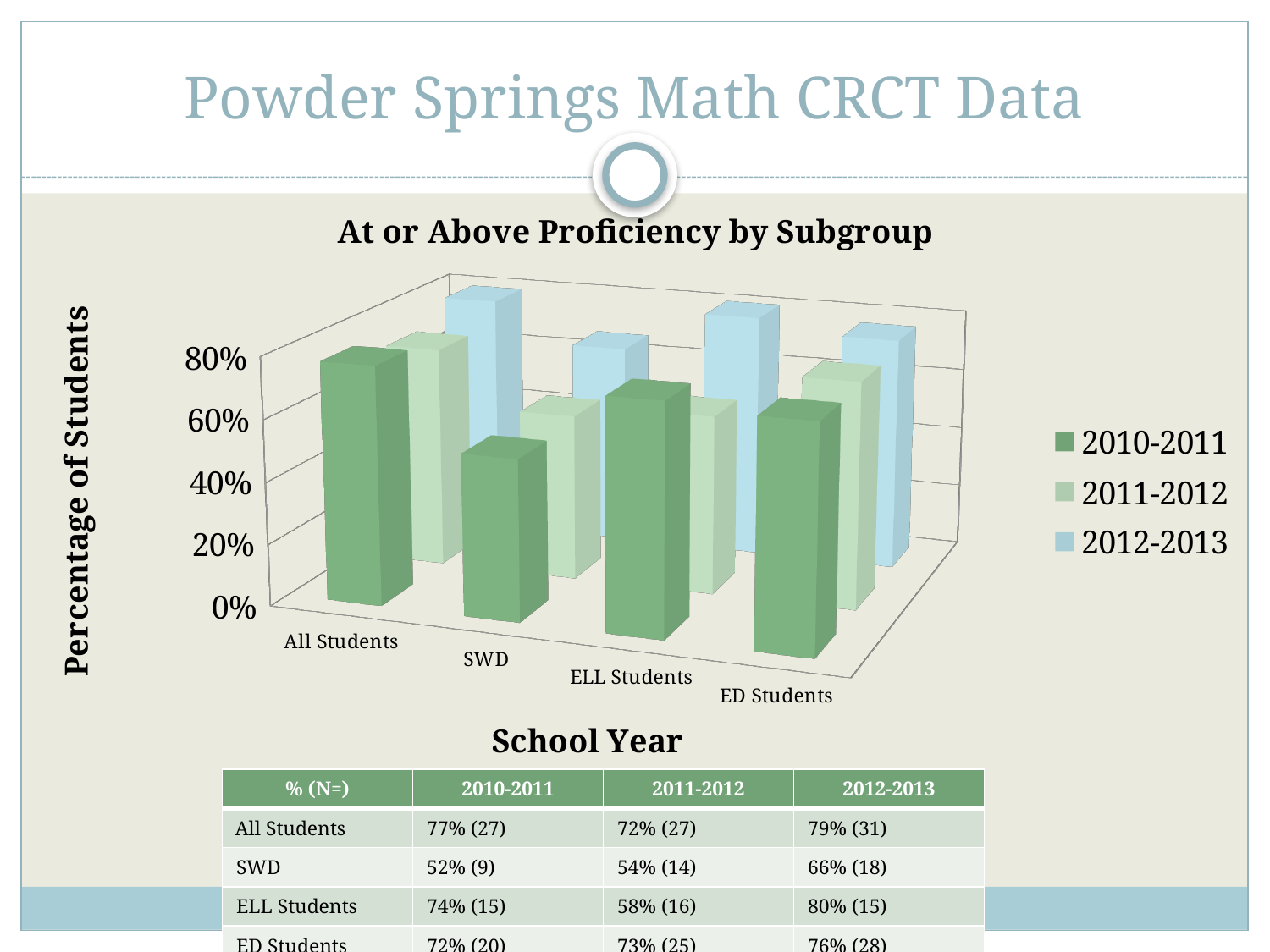
Is the value for SWD in 2010-2011 greater or less than 60%? less What percentage of ELL Students were at or above proficiency in 2011-2012? 58% Which is larger for ELL Students: the 2010-2011 value or the 2011-2012 value? 2010-2011 Which subgroup had the highest percentage at or above proficiency in 2012-2013? ELL Students What percentage of SWD students were at or above proficiency in 2010-2011? 52% What type of chart is shown on the slide? bar chart What is the difference between the SWD percentage in 2012-2013 and in 2010-2011? 14% What is the title of the chart? At or Above Proficiency by Subgroup Which subgroup had the lowest percentage at or above proficiency in 2010-2011? SWD How many series does the legend list? 3 How many subgroup categories are shown on the x axis? 4 What percentage of All Students were at or above proficiency in 2012-2013? 79%